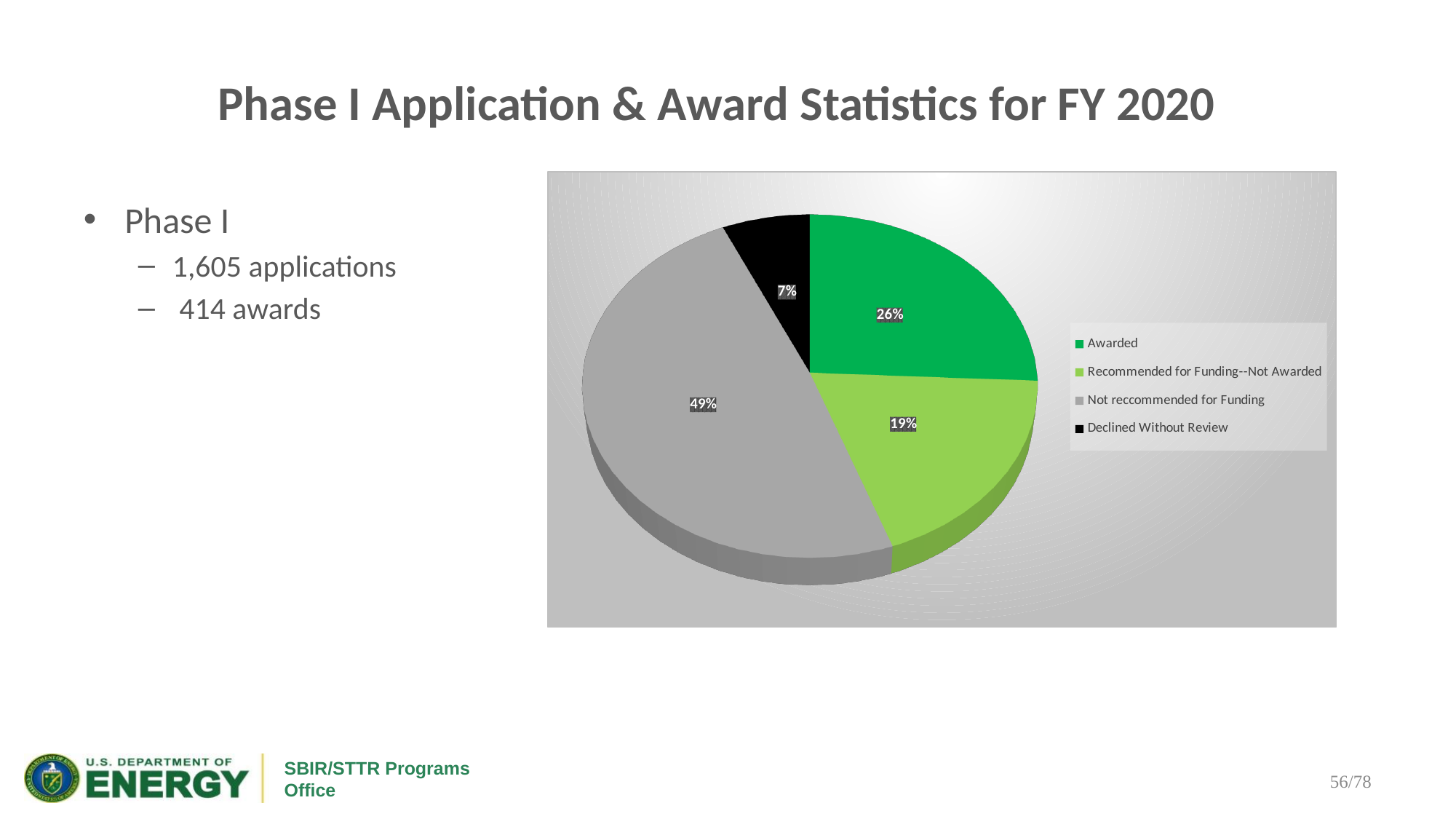
Which category has the smallest slice of the pie? Declined Without Review What share of the pie is labelled Not reccommended for Funding? 49% How many slices does the pie chart have? 4 How many entries does the legend list? 4 Which category has the largest slice of the pie? Not reccommended for Funding What kind of chart is shown on the slide? pie chart Which slice is larger, Awarded or Recommended for Funding--Not Awarded? Awarded What share of the pie is labelled Recommended for Funding--Not Awarded? 19% What share of the pie is labelled Declined Without Review? 7% What colour is the Declined Without Review slice? black What share of the pie is labelled Awarded? 26% What is the difference in percentage points between the Not reccommended for Funding slice and the Awarded slice? 23